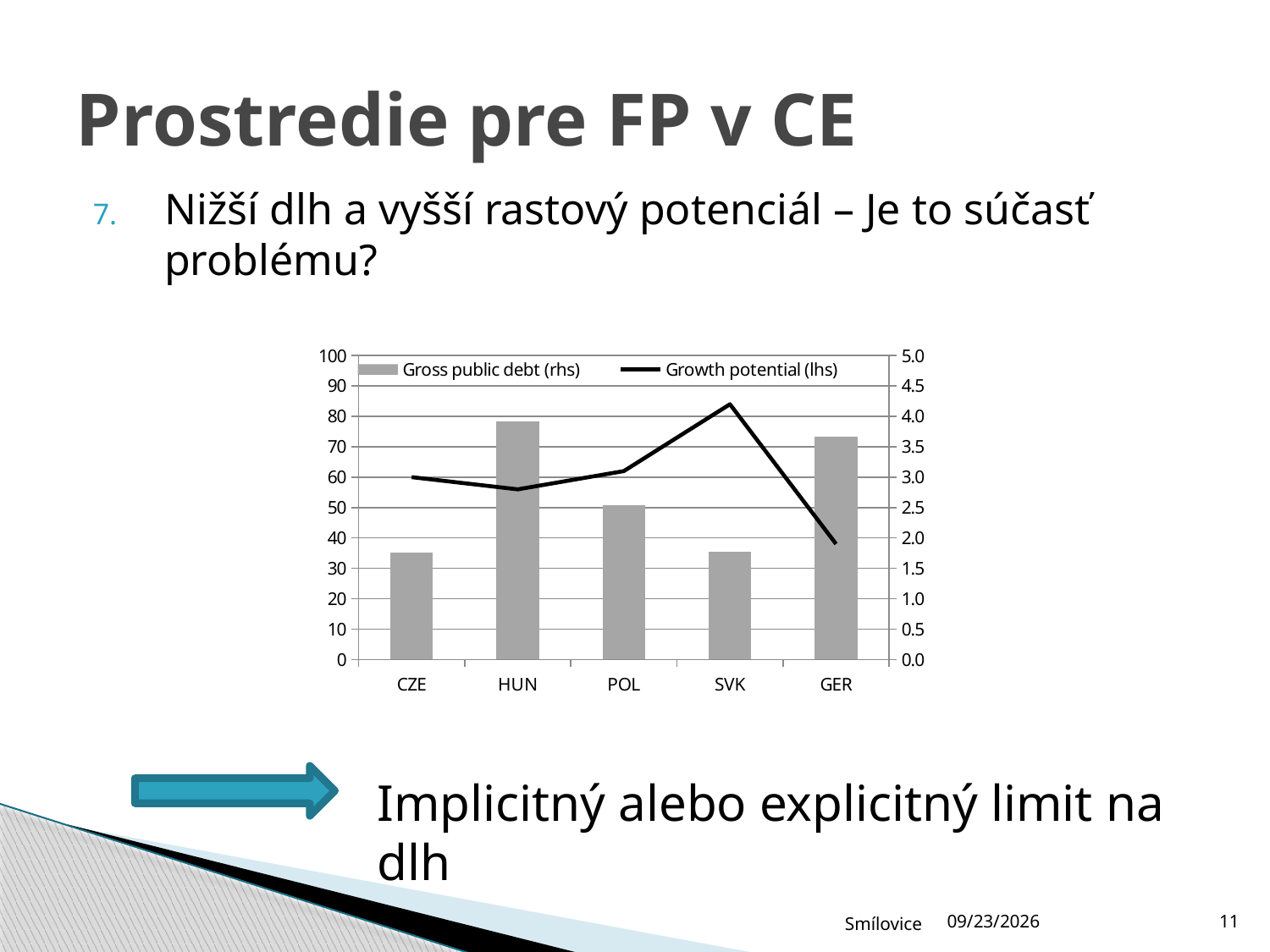
Does the Growth potential line rise or fall from SVK to GER? fall Is the bar for CZE greater or less than 40 on the left axis? less How many series does the chart legend list? 2 What kind of chart is shown on the slide? Combined bar and line chart Which country has the lowest point on the Growth potential line? GER Is the Growth potential point for GER greater or less than 2.5 on the right axis? less Which country has the highest point on the Growth potential line? SVK Which country has the tallest bar in the chart? HUN How many countries are shown on the x axis of the chart? 5 Is the bar for POL greater or less than 60 on the left axis? less Which bar is taller, HUN or GER? HUN